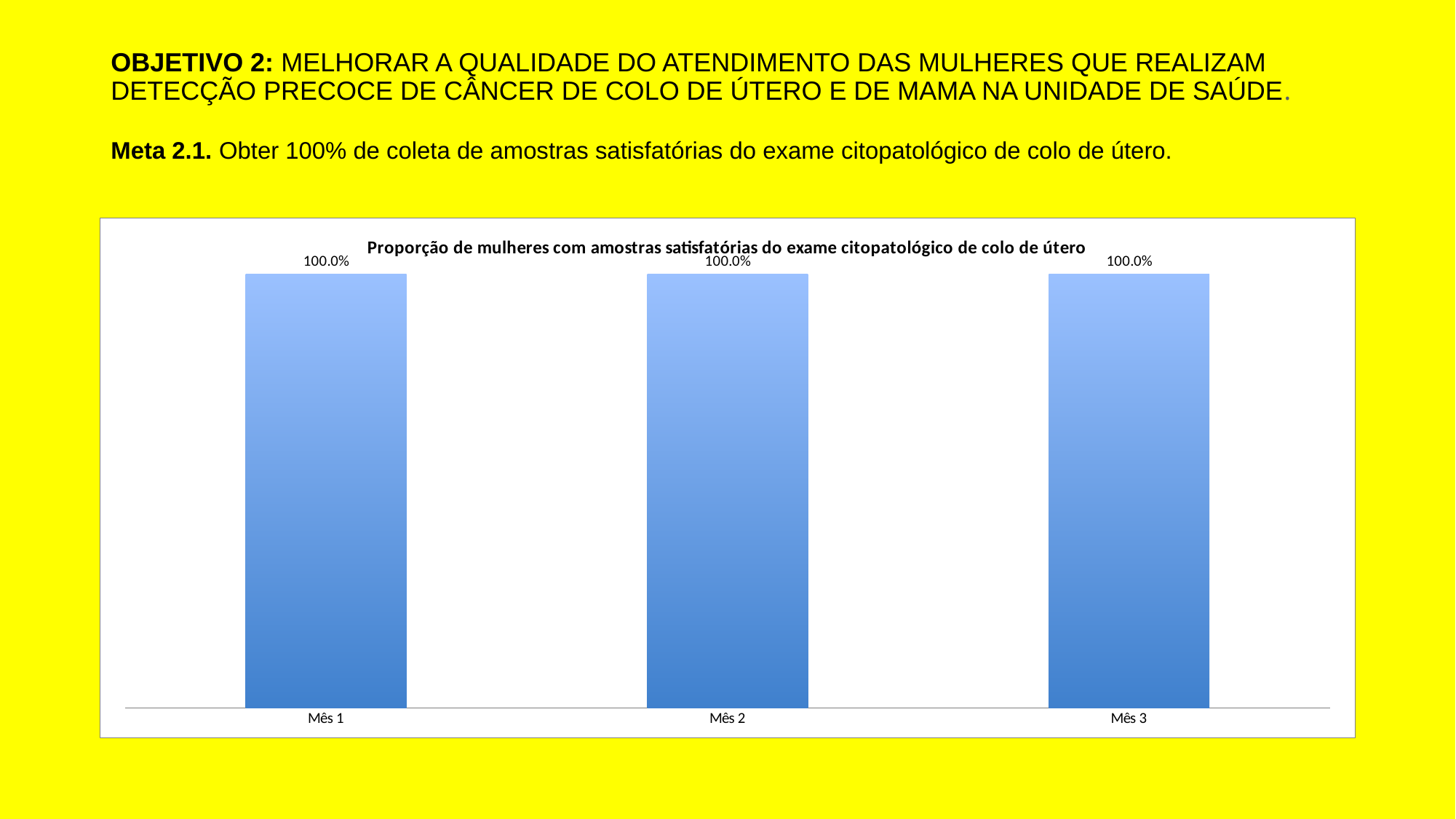
What is the value for Mês 2? 100.0% What is the value for Mês 1? 100.0% Do the values rise, fall or stay the same from Mês 1 to Mês 3? stay the same What is the value for Mês 3? 100.0% How many categories are shown on the x axis? 3 What kind of chart is shown on the slide? bar chart What is the title of the chart? Proporção de mulheres com amostras satisfatórias do exame citopatológico de colo de útero What is the difference between the values for Mês 1 and Mês 3? 0.0% What is the label of the first category on the x axis? Mês 1